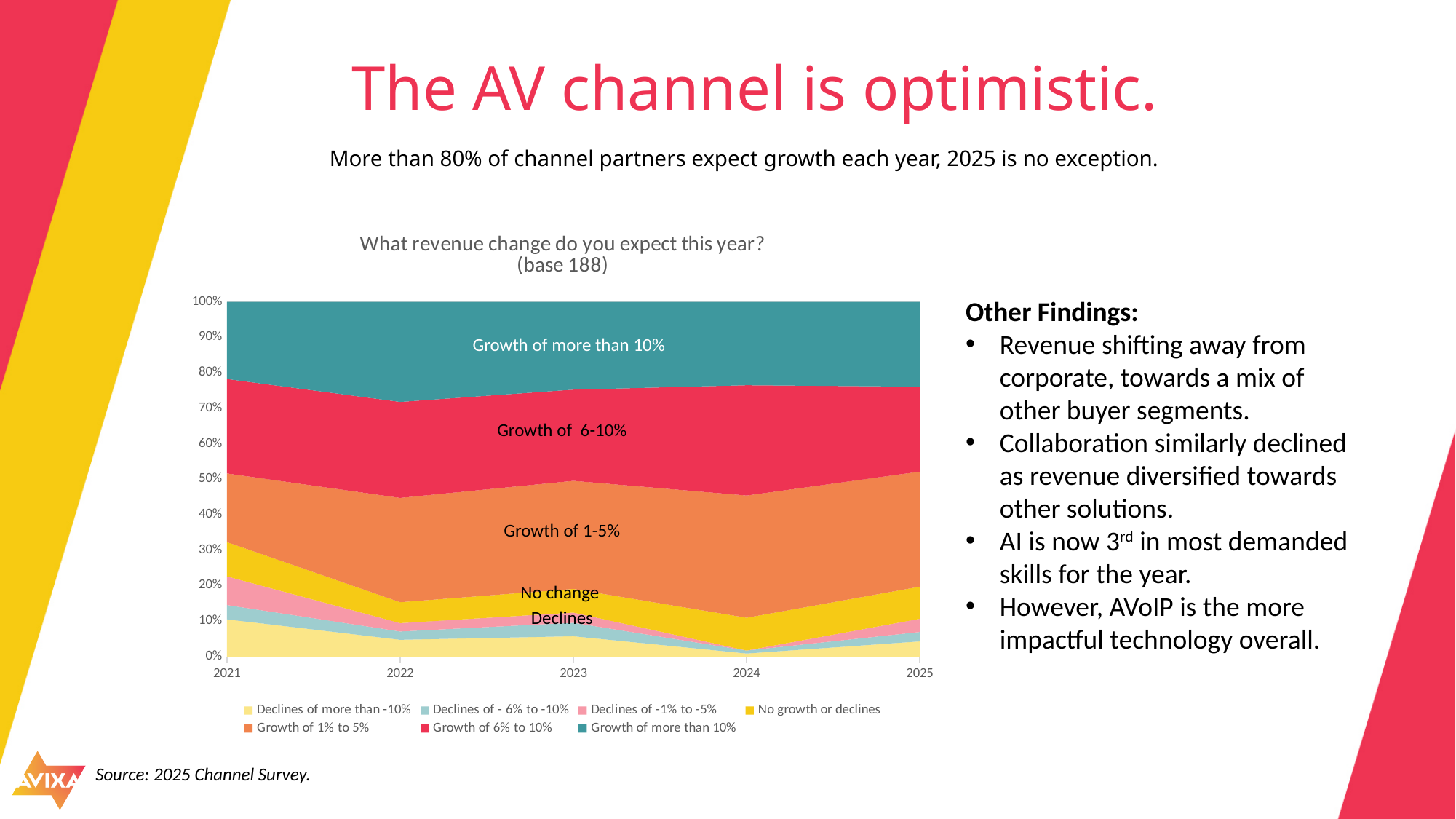
How many series does the chart's legend list? 7 What kind of chart is shown on the slide? Area chart Which year is the first on the x axis of the chart? 2021 Is the share for 'Declines of more than -10%' in 2022 greater or less than 10%? less What is the title of the chart? What revenue change do you expect this year? (base 188) Which series is plotted at the top of the stacked area chart? Growth of more than 10% Does the share for 'Declines of more than -10%' rise or fall from 2021 to 2024? fall In which year is the share for 'Declines of more than -10%' lowest? 2024 Is the share for 'Declines of more than -10%' in 2024 greater or less than 10%? less Which year has the larger share for 'Declines of more than -10%', 2021 or 2024? 2021 How many years are plotted along the x axis of the chart? 5 Which year is the last on the x axis of the chart? 2025